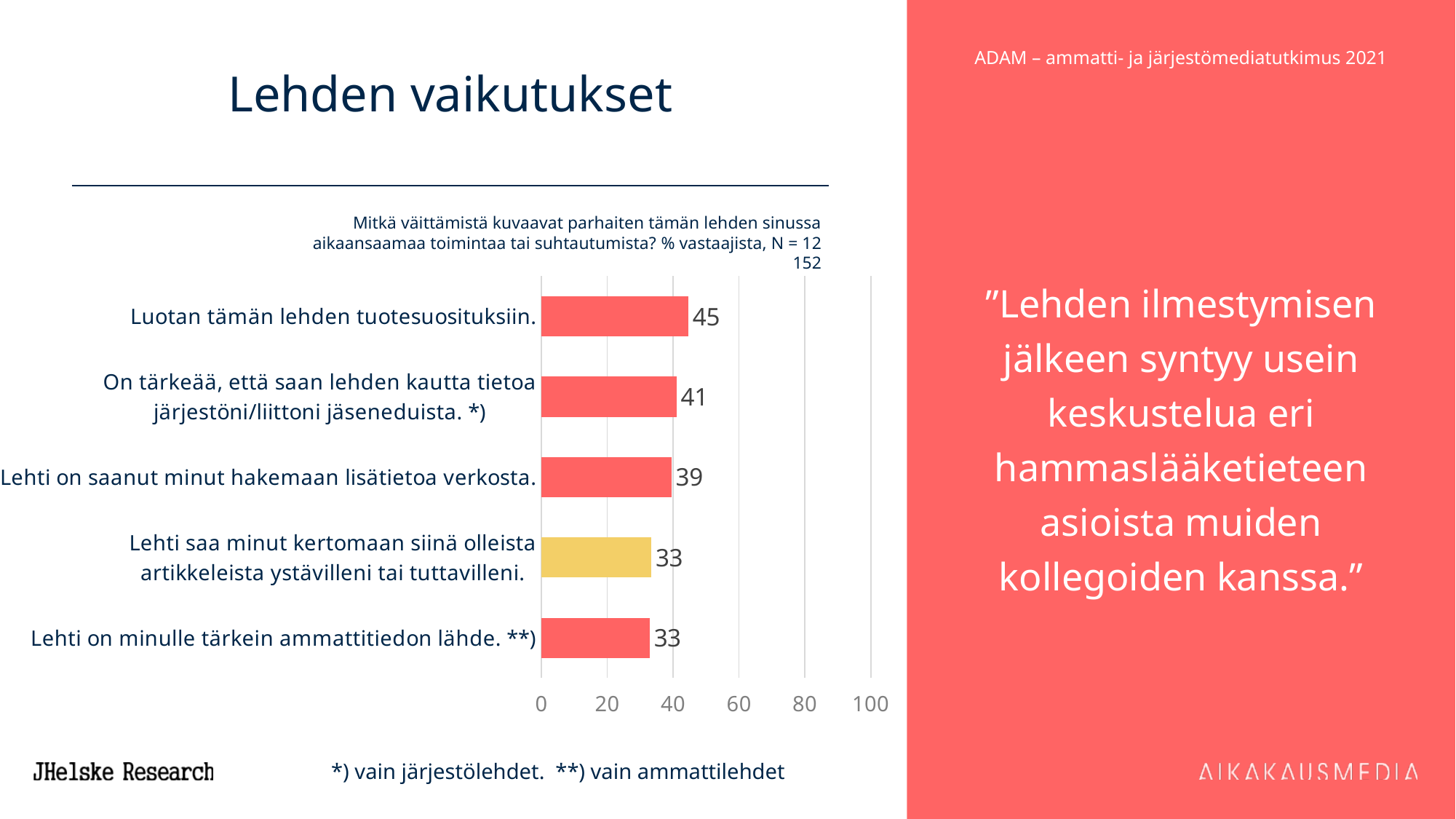
Is the value for "Luotan tämän lehden tuotesuosituksiin." greater or less than 60? less What is the value for "Lehti on minulle tärkein ammattitiedon lähde. **)"? 33 Which bar is coloured yellow instead of red? Lehti saa minut kertomaan siinä olleista artikkeleista ystävilleni tai tuttavilleni. What is the value for "On tärkeää, että saan lehden kautta tietoa järjestöni/liittoni jäseneduista. *)"? 41 Which is larger: the value for "On tärkeää, että saan lehden kautta tietoa järjestöni/liittoni jäseneduista. *)" or the value for "Lehti on saanut minut hakemaan lisätietoa verkosta."? On tärkeää, että saan lehden kautta tietoa järjestöni/liittoni jäseneduista. *) What is the value for "Lehti on saanut minut hakemaan lisätietoa verkosta."? 39 How many statements (bars) are shown in the chart? 5 What is the title of the slide containing the chart? Lehden vaikutukset What is the value for "Luotan tämän lehden tuotesuosituksiin."? 45 What is the difference between the values for "Luotan tämän lehden tuotesuosituksiin." and "Lehti on minulle tärkein ammattitiedon lähde. **)"? 12 What kind of chart is shown on the slide? bar chart Which statement has the highest value? Luotan tämän lehden tuotesuosituksiin.